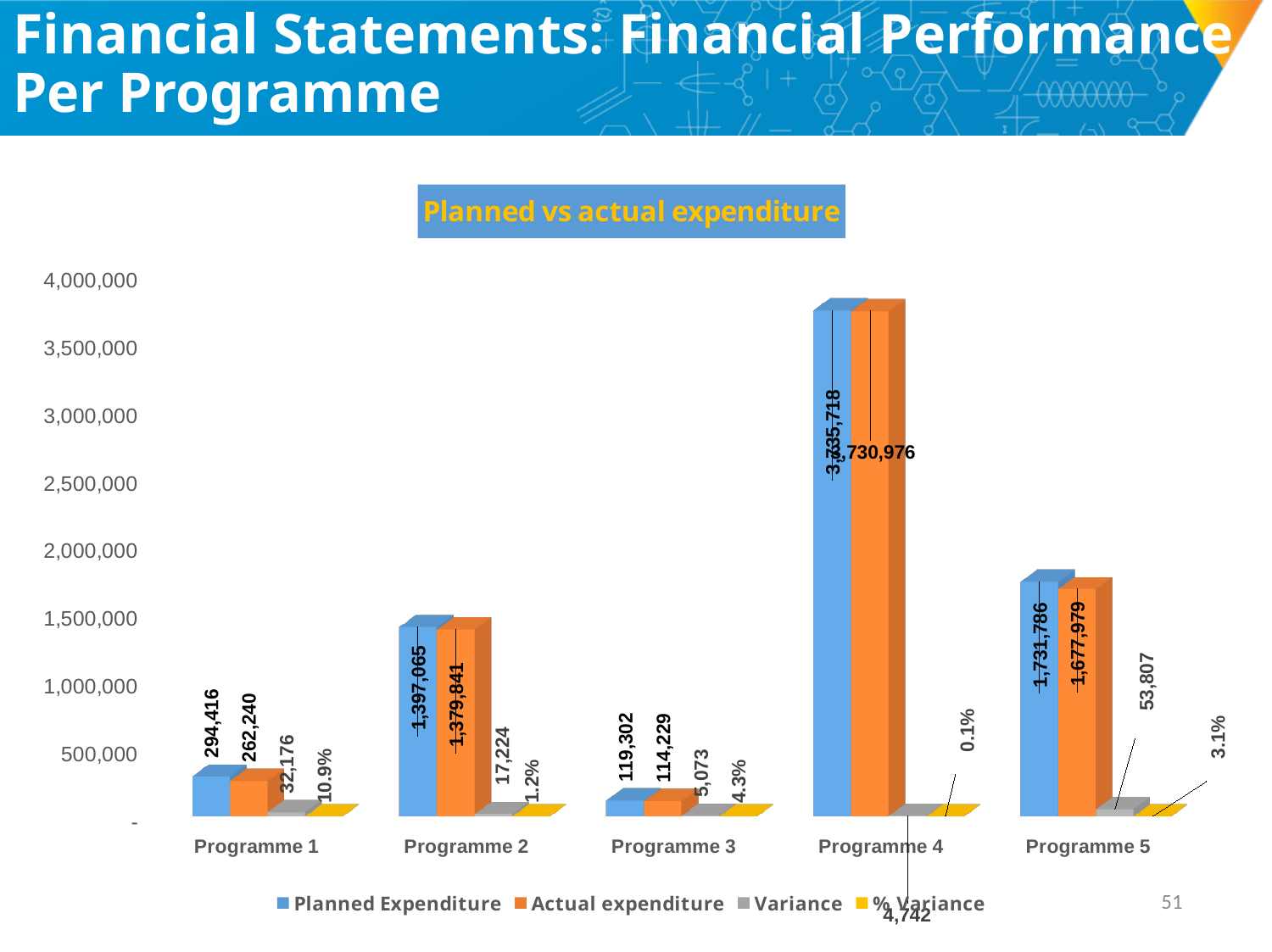
What is the Actual expenditure for Programme 5? 1,677,979 What kind of chart is shown on the slide? Bar chart What is the Variance for Programme 2? 17,224 What is the Planned Expenditure for Programme 1? 294,416 How many programmes are shown on the x axis? 5 Which programme has the lowest Actual expenditure? Programme 3 Which is larger, the Actual expenditure for Programme 2 or for Programme 5? Programme 5 What is the difference between Planned Expenditure and Actual expenditure for Programme 5? 53,807 Is the Planned Expenditure for Programme 4 greater or less than 3,500,000? greater What is the % Variance for Programme 3? 4.3% Which programme has the highest Planned Expenditure? Programme 4 How many series does the legend list? 4